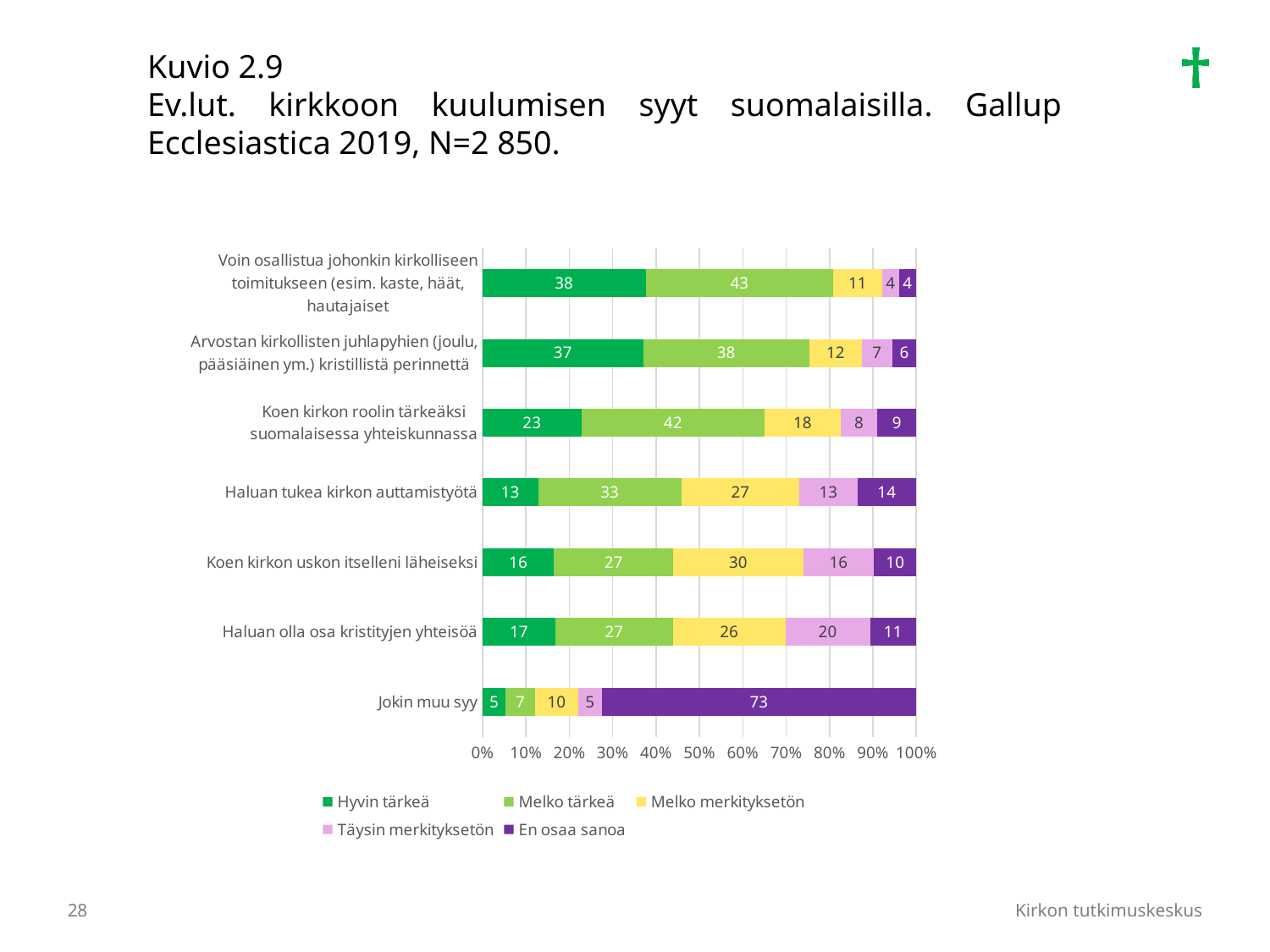
What is the difference between the 'Täysin merkityksetön' values for 'Haluan olla osa kristityjen yhteisöä' and 'Haluan tukea kirkon auttamistyötä'? 7 How many categories (reasons) are plotted on the chart? 7 What is the 'En osaa sanoa' value for 'Jokin muu syy'? 73 Which is larger: the 'Melko tärkeä' value for 'Arvostan kirkollisten juhlapyhien (joulu, pääsiäinen ym.) kristillistä perinnettä' or for 'Koen kirkon roolin tärkeäksi suomalaisessa yhteiskunnassa'? Koen kirkon roolin tärkeäksi suomalaisessa yhteiskunnassa Which legend entry is shown in dark purple? En osaa sanoa What is the total of the stacked bar for 'Haluan tukea kirkon auttamistyötä'? 100 Which category has the lowest 'Melko tärkeä' value? Jokin muu syy How many series does the legend list? 5 Which category has the highest 'Hyvin tärkeä' value? Voin osallistua johonkin kirkolliseen toimitukseen (esim. kaste, häät, hautajaiset What type of chart is shown on the slide? Stacked bar chart What is the 'Hyvin tärkeä' value for 'Koen kirkon roolin tärkeäksi suomalaisessa yhteiskunnassa'? 23 What is the 'Melko merkityksetön' value for 'Koen kirkon uskon itselleni läheiseksi'? 30